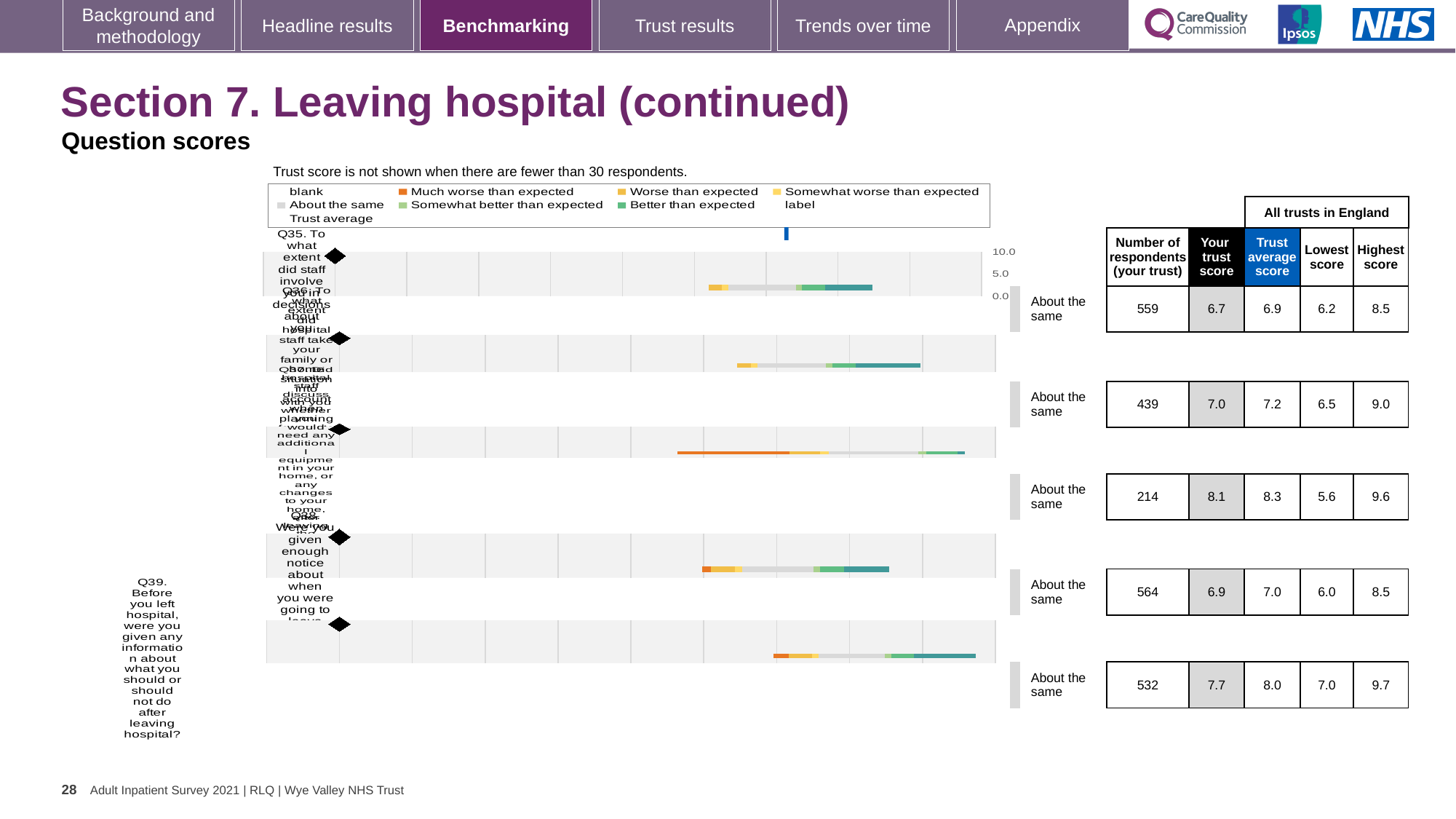
What is the highest score across all trusts in England for Q39? 9.7 What is the difference between the trust average score and your trust score for Q39? 0.3 Is the lowest score for Q37 greater or less than 6.0? less Which has the larger 'Your trust score': Q36 or Q38? Q36 How many questions are shown on the chart? 5 What is the trust average score for Q36? 7.2 Which question has the highest 'Your trust score'? Q37 What kind of chart is used to show the question scores? bar chart What is the 'Your trust score' for Q35 (To what extent did staff involve you in decisions about you leaving hospital)? 6.7 Which question has the fewest respondents from your trust? Q37 How many respondents from your trust answered Q37? 214 What benchmark category is shown for Q38? About the same